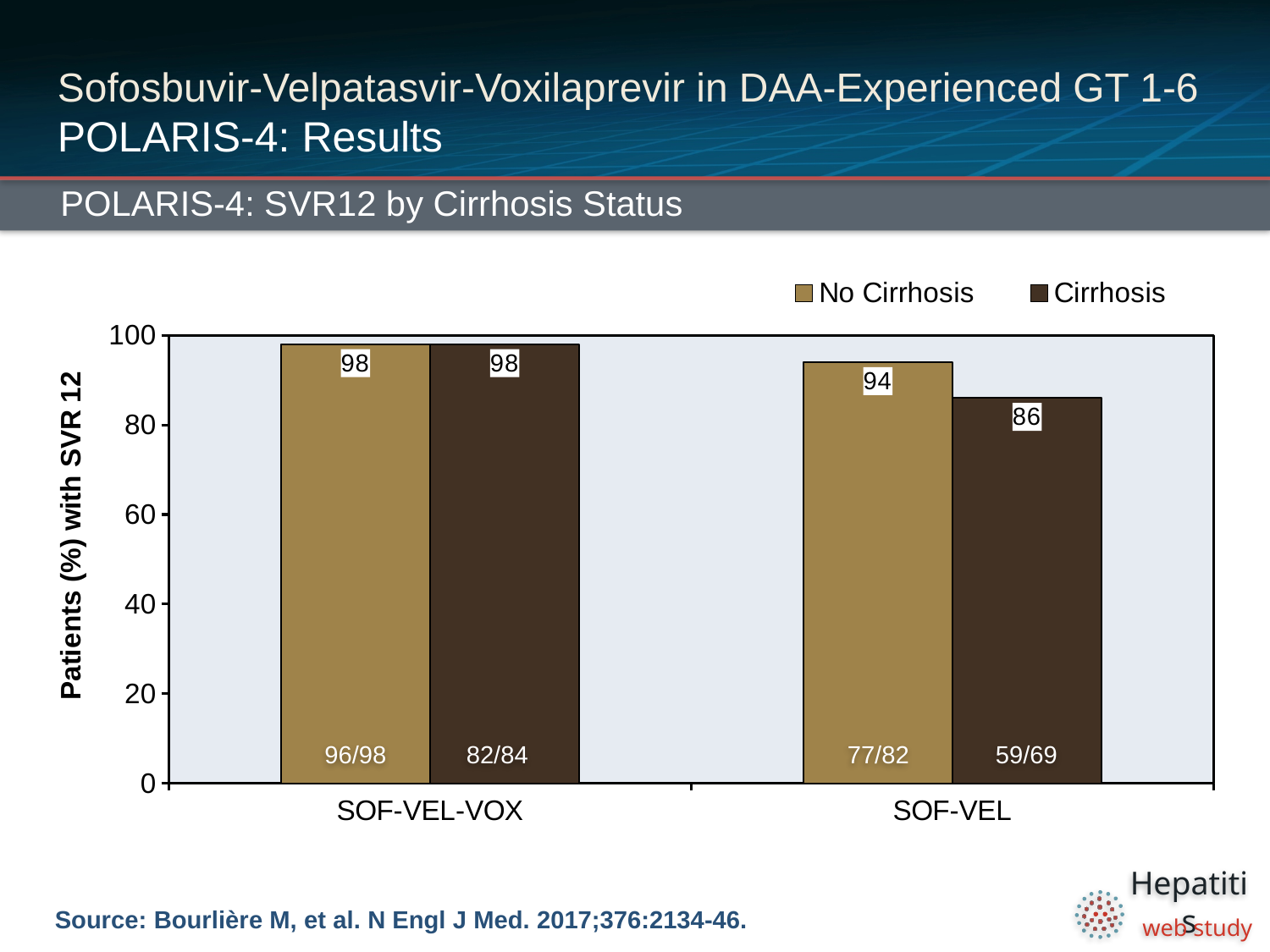
What is the title of the chart? POLARIS-4: SVR12 by Cirrhosis Status What is the SVR12 rate for patients with no cirrhosis in the SOF-VEL group? 94 How many series does the legend list? 2 What fraction of patients is shown for the cirrhosis bar in the SOF-VEL-VOX group? 82/84 How many treatment groups are shown on the x axis? 2 Which bar has the lowest SVR12 rate on the chart? Cirrhosis, SOF-VEL Which is larger: the SVR12 rate for no cirrhosis in SOF-VEL or for cirrhosis in SOF-VEL? No cirrhosis in SOF-VEL What is the SVR12 rate for patients with no cirrhosis in the SOF-VEL-VOX group? 98 What is the label of the y axis? Patients (%) with SVR 12 What is the difference in SVR12 rate between the no cirrhosis and cirrhosis bars in the SOF-VEL group? 8 What is the SVR12 rate for patients with cirrhosis in the SOF-VEL group? 86 What kind of chart is shown on the slide? Bar chart